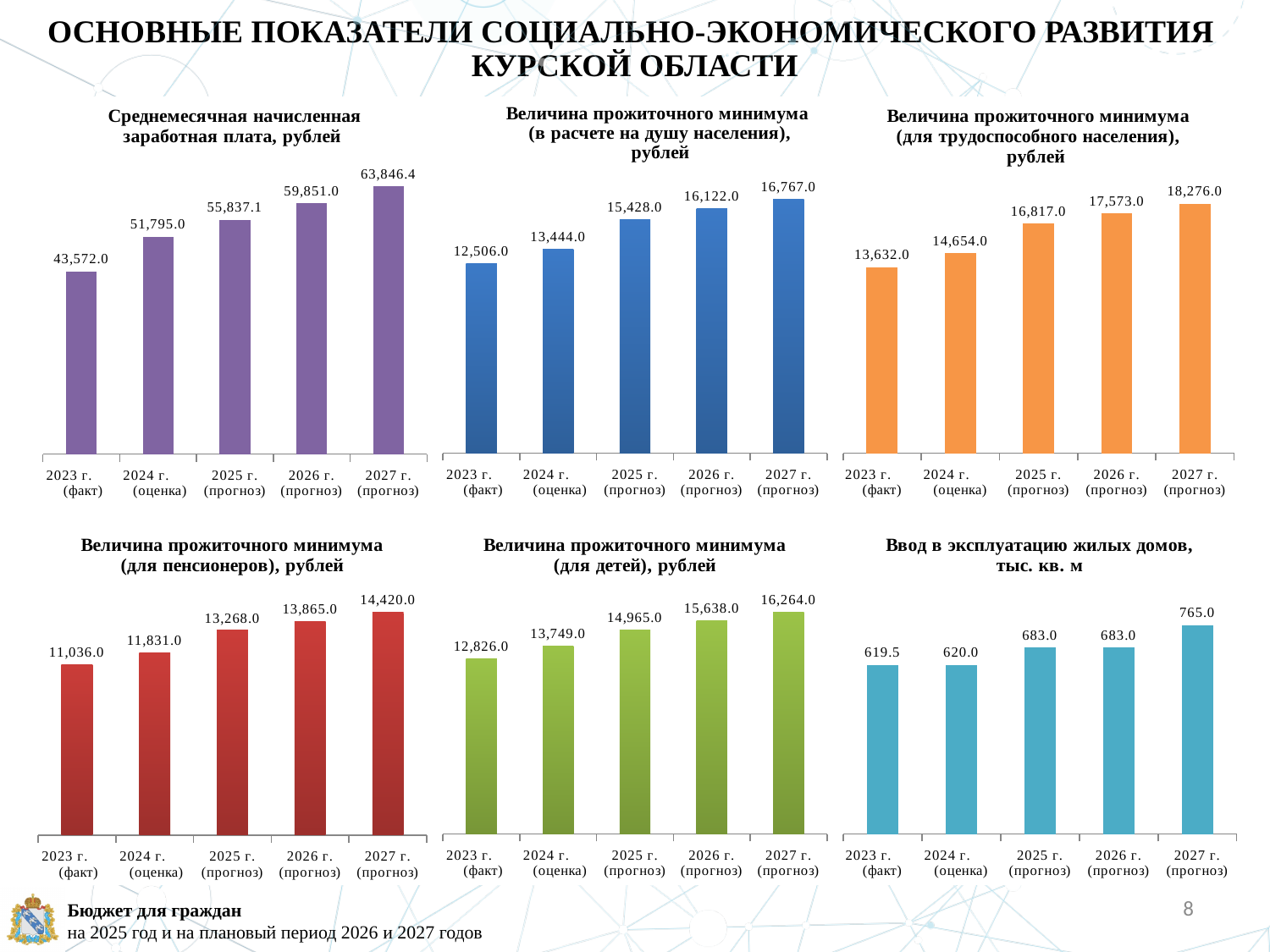
How many charts are shown on the slide? 6 In the chart 'Величина прожиточного минимума (для трудоспособного населения), рублей', which year has the highest value? 2027 г. (прогноз) In the chart 'Величина прожиточного минимума (для детей), рублей', which is larger: the value for 2024 г. (оценка) or the value for 2026 г. (прогноз)? 2026 г. (прогноз) In the chart 'Среднемесячная начисленная заработная плата, рублей', what is the value for 2027 г. (прогноз)? 63,846.4 What type of chart is 'Величина прожиточного минимума (для детей), рублей'? Bar chart In the chart 'Величина прожиточного минимума (в расчете на душу населения), рублей', what is the value for 2025 г. (прогноз)? 15,428.0 In the chart 'Величина прожиточного минимума (для пенсионеров), рублей', what is the difference between the 2027 г. (прогноз) value and the 2023 г. (факт) value? 3,384.0 In the chart 'Ввод в эксплуатацию жилых домов, тыс. кв. м', what is the difference between the 2027 г. (прогноз) value and the 2023 г. (факт) value? 145.5 In the chart 'Среднемесячная начисленная заработная плата, рублей', do the values rise or fall from 2023 г. to 2027 г.? Rise In the chart 'Среднемесячная начисленная заработная плата, рублей', what is the value for 2023 г. (факт)? 43,572.0 How many bars are in the chart 'Ввод в эксплуатацию жилых домов, тыс. кв. м'? 5 In the chart 'Величина прожиточного минимума (для пенсионеров), рублей', which year has the lowest value? 2023 г. (факт)